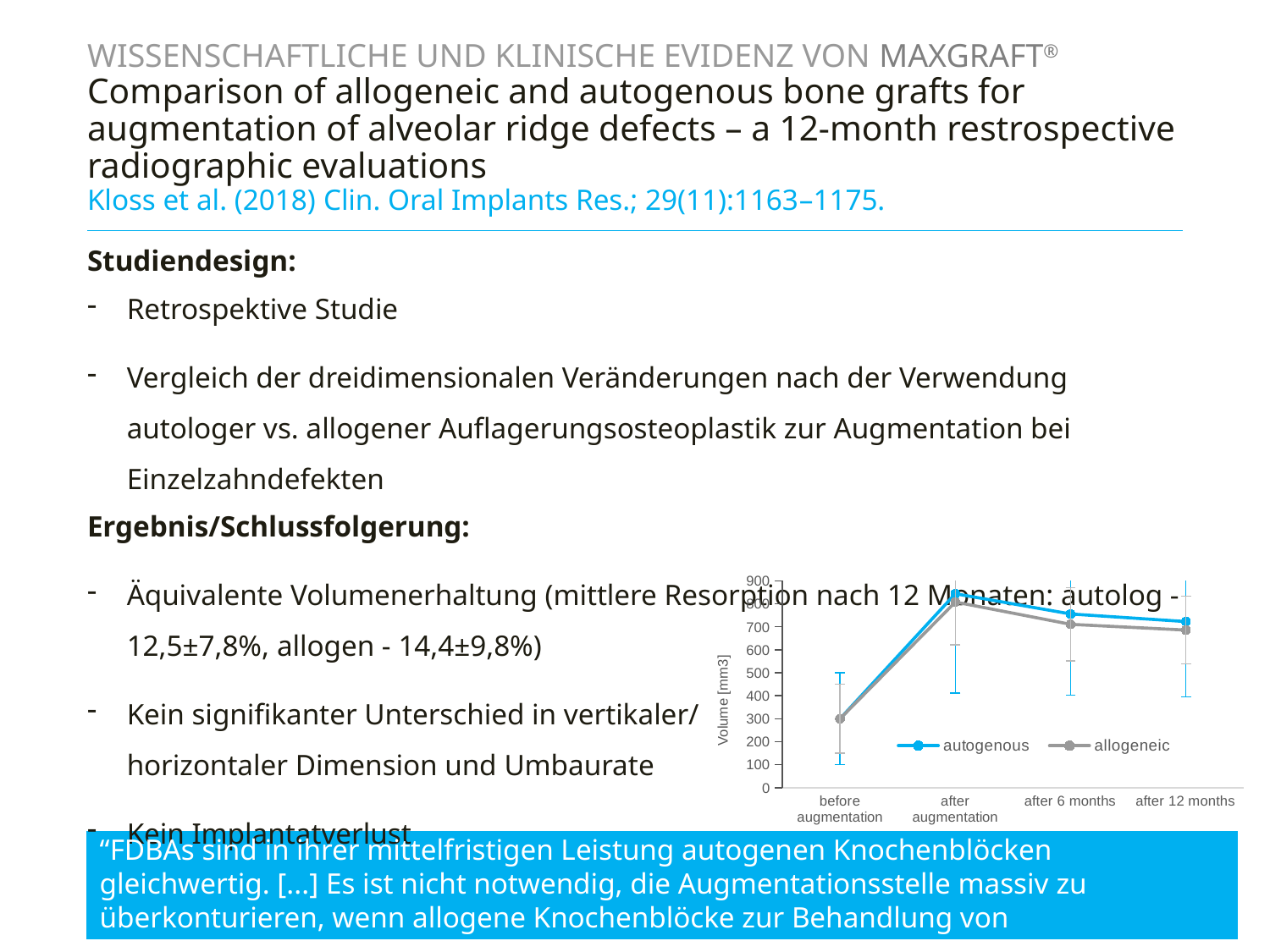
From after augmentation to after 12 months, do the volumes of both series rise or fall? fall What is the label of the vertical axis of the chart? Volume [mm3] Is the volume for the autogenous series before augmentation greater or less than 400? less What kind of chart is shown on the slide? line chart Is the volume for the allogeneic series after 6 months greater or less than 800? less At which time point does the autogenous series reach its highest volume? after augmentation Which two series are listed in the chart legend? autogenous and allogeneic At which time point does the allogeneic series have its lowest volume? before augmentation How many series does the chart legend list? 2 How many time points are plotted along the x axis of the chart? 4 Is the volume for the autogenous series after 12 months greater or less than 600? greater